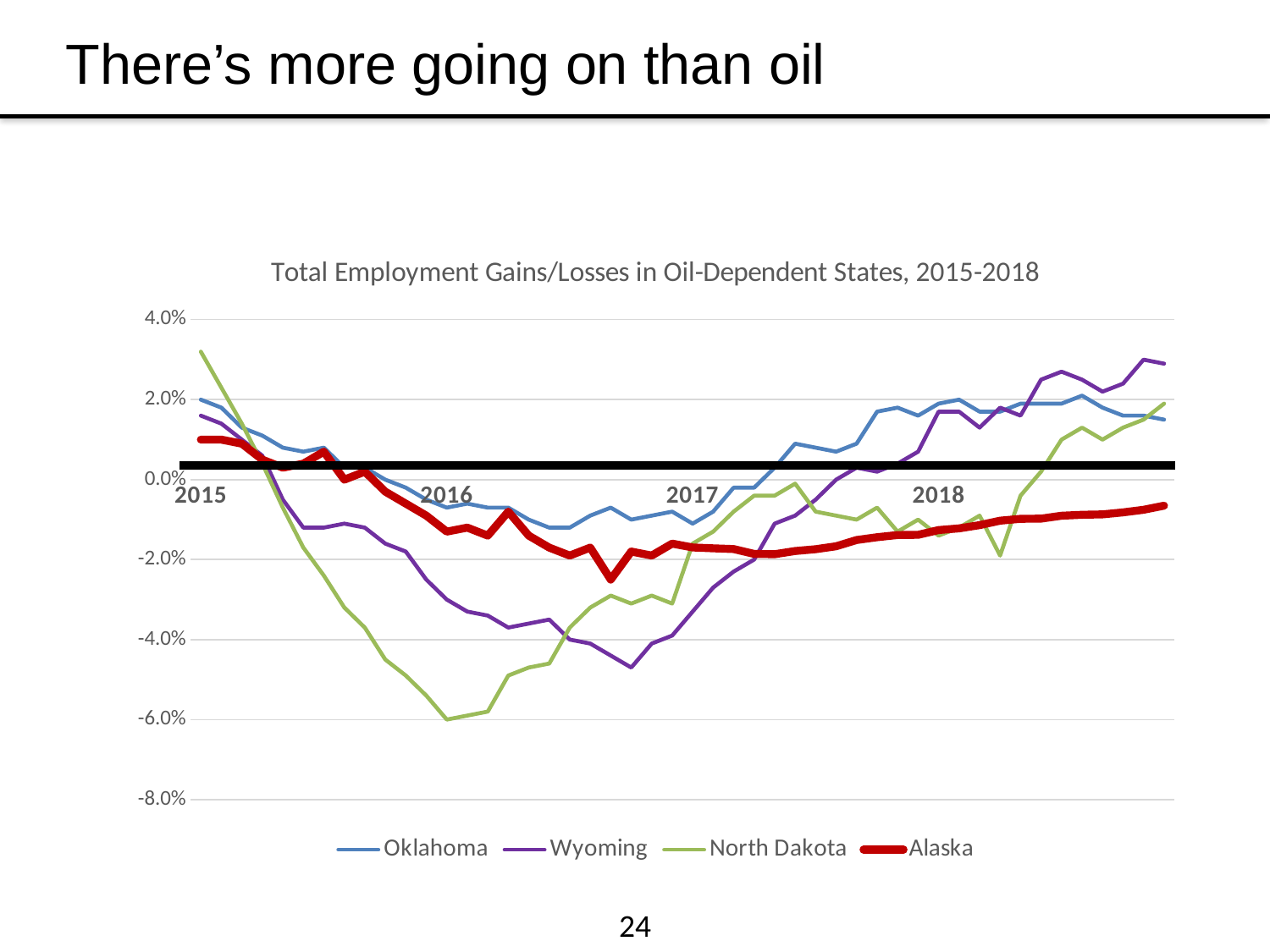
Is the value for Alaska at the right end of the chart greater or less than 0.0%? less What kind of chart is shown on the slide? Line chart At the start of 2015, which is higher: North Dakota or Alaska? North Dakota Is the lowest value for North Dakota greater or less than -4.0%? less Which state's line is highest at the right end of the chart (end of 2018)? Wyoming Which series is drawn with the thick red line? Alaska Is the lowest value for Oklahoma greater or less than -2.0%? greater Which state's line reaches the lowest value on the chart? North Dakota Does the Alaska line rise or fall between 2017 and 2018? Rise How many series does the legend list? 4 What is the title of the chart? Total Employment Gains/Losses in Oil-Dependent States, 2015-2018